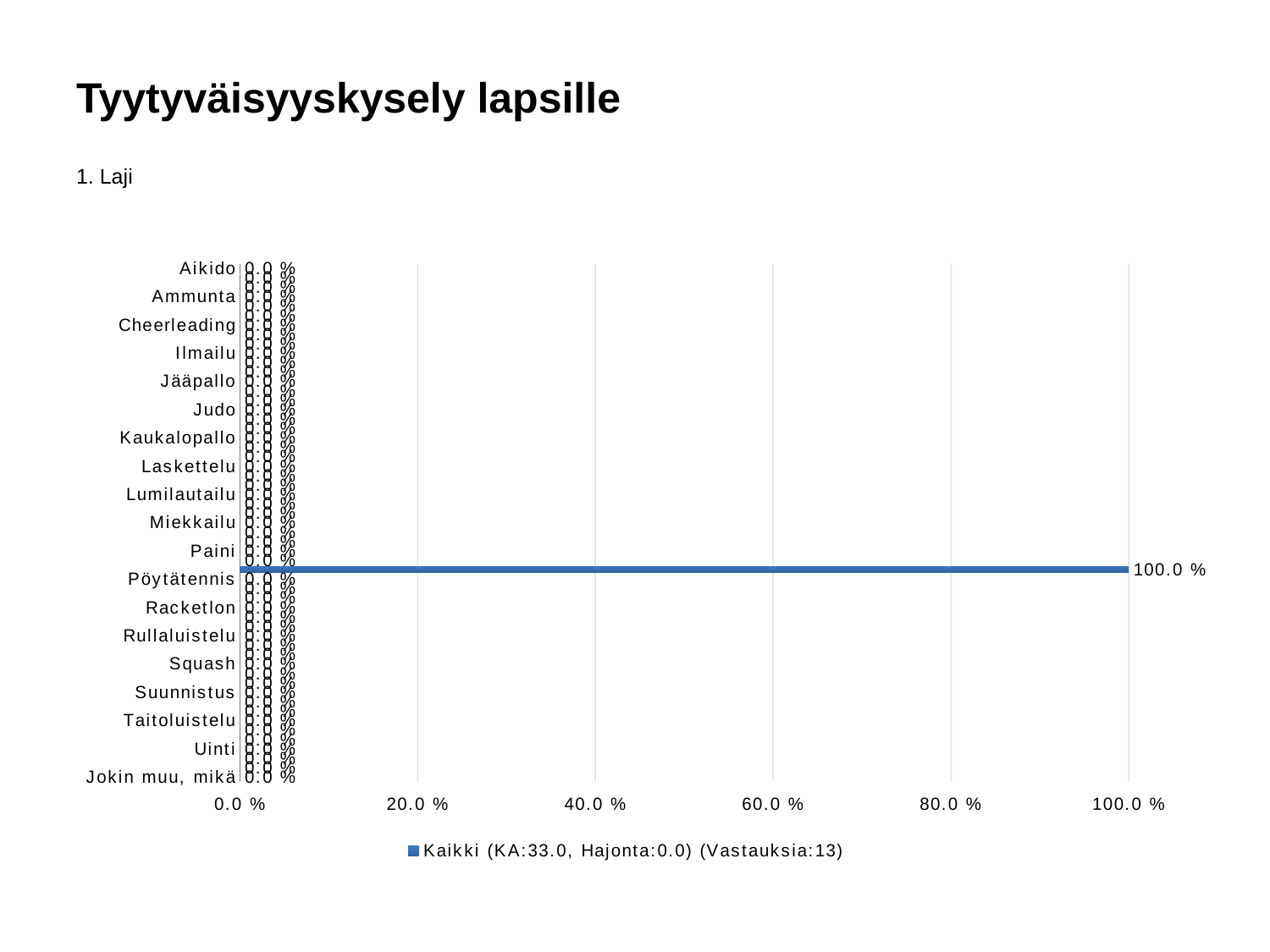
How many categories are shown on the chart? 55 What is the value for Aikido? 0.0 % What is the value for Uinti? 0.0 % What kind of chart is shown on the slide? bar chart How many series does the legend list? 1 What is the label of the last category at the bottom of the chart? Jokin muu, mikä What is the legend entry of the series shown? Kaikki (KA:33.0, Hajonta:0.0) (Vastauksia:13)